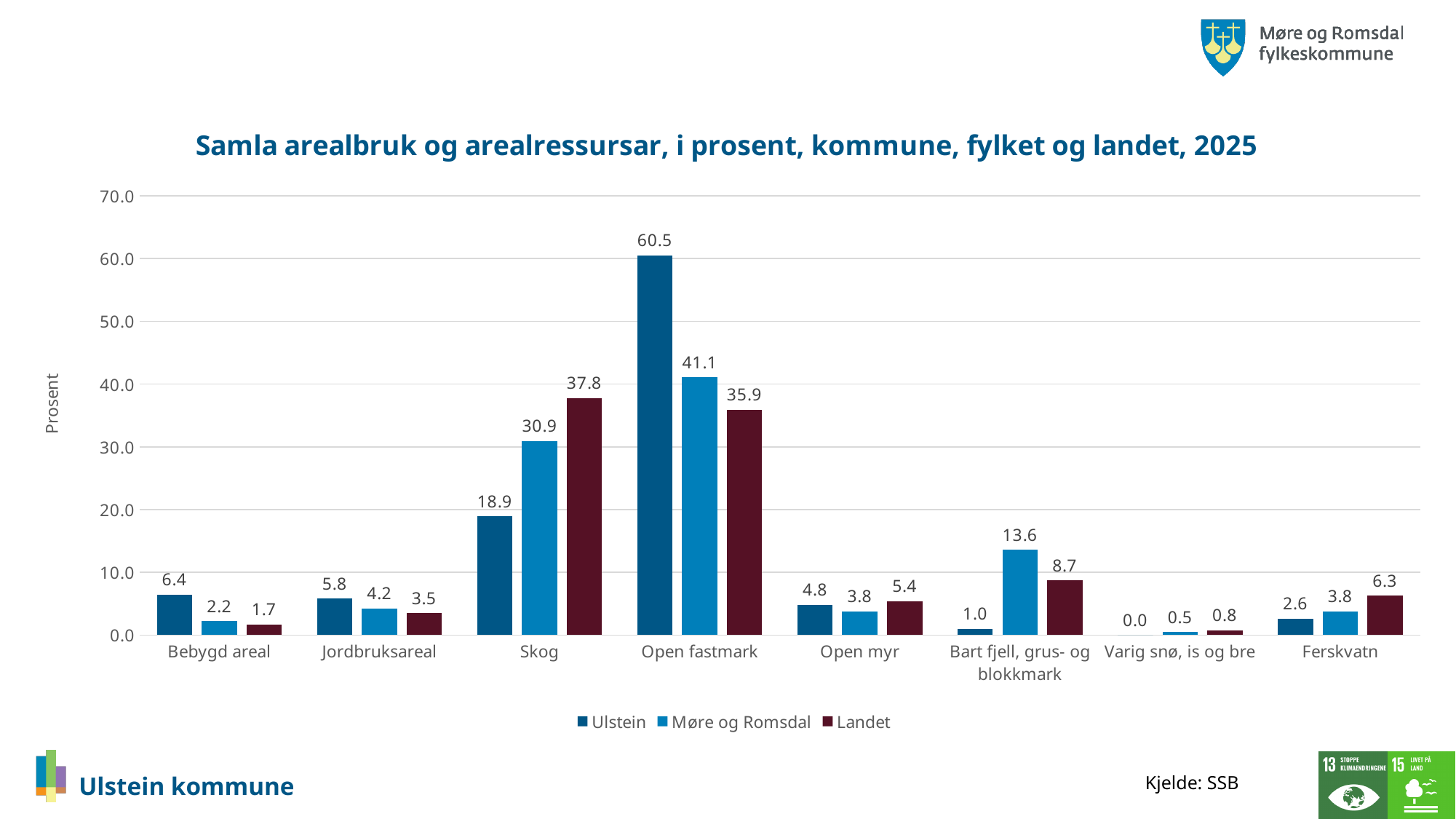
What is the value for Møre og Romsdal in the Bart fjell, grus- og blokkmark category? 13.6 What kind of chart is shown on the slide? Bar chart Which is larger for Skog: the value for Ulstein or the value for Møre og Romsdal? Møre og Romsdal Which category has the lowest value for Landet? Varig snø, is og bre What is the value for Landet in the Skog category? 37.8 How many series does the legend list? 3 Is the value for Møre og Romsdal in Open fastmark greater or less than 40.0? greater What is the difference between the Ulstein and Landet values for Open fastmark? 24.6 What is the label of the y axis? Prosent How many categories are shown on the x axis? 8 What is the value for Ulstein in the Open fastmark category? 60.5 Which category has the highest value for Ulstein? Open fastmark